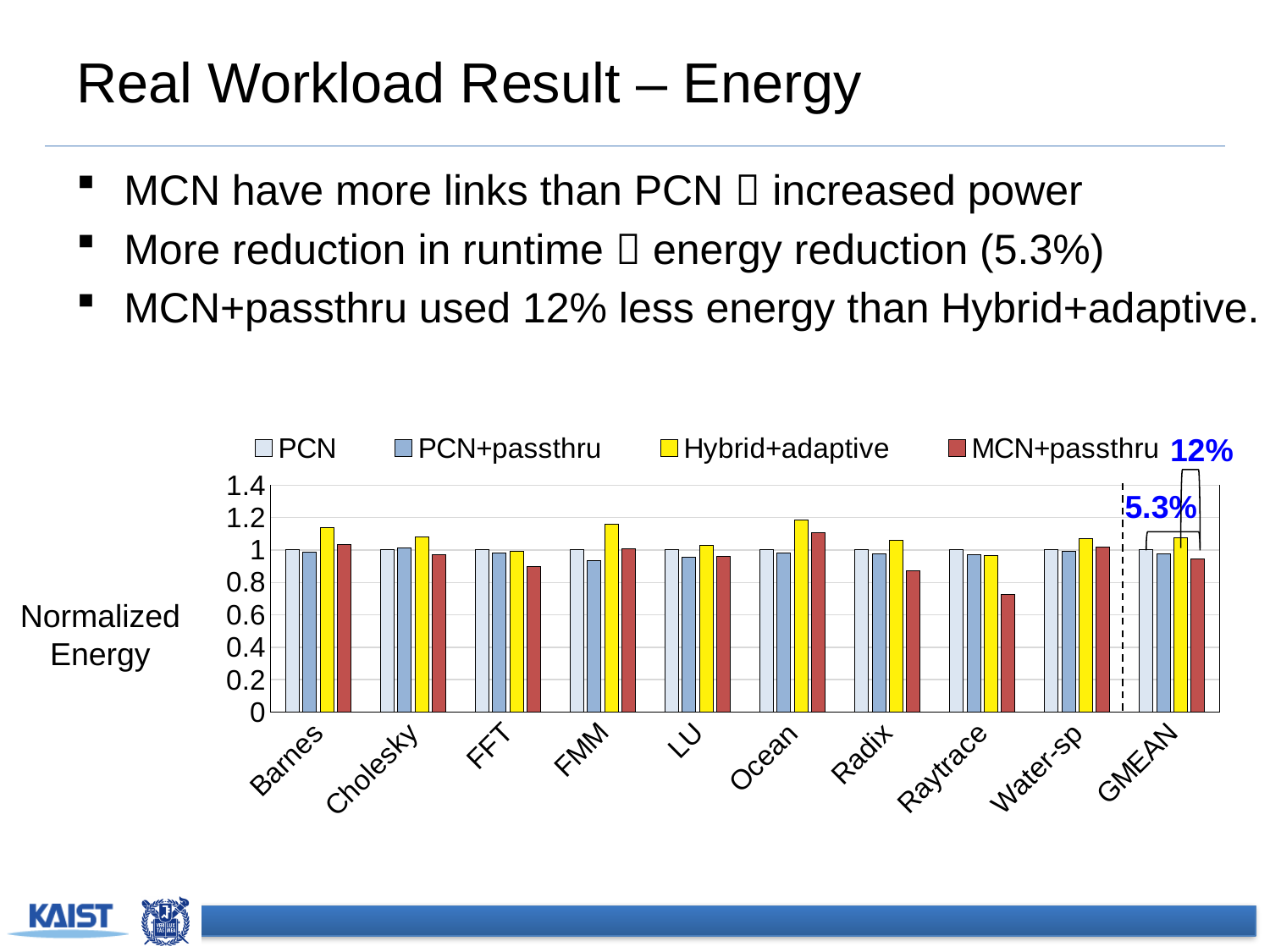
Is the Hybrid+adaptive value for Ocean greater or less than 1? greater What is the label on the y axis of the chart? Normalized Energy For Raytrace, which is larger: the Hybrid+adaptive value or the MCN+passthru value? Hybrid+adaptive How many categories are shown along the x axis of the chart? 10 How many series does the chart legend list? 4 What is the PCN value for Barnes? 1 What kind of chart is shown on the slide? bar chart Which series is shown in yellow in the chart legend? Hybrid+adaptive Is the MCN+passthru value for Radix greater or less than 1? less Which category has the lowest MCN+passthru value? Raytrace Is the Hybrid+adaptive value for FMM greater or less than 1? greater